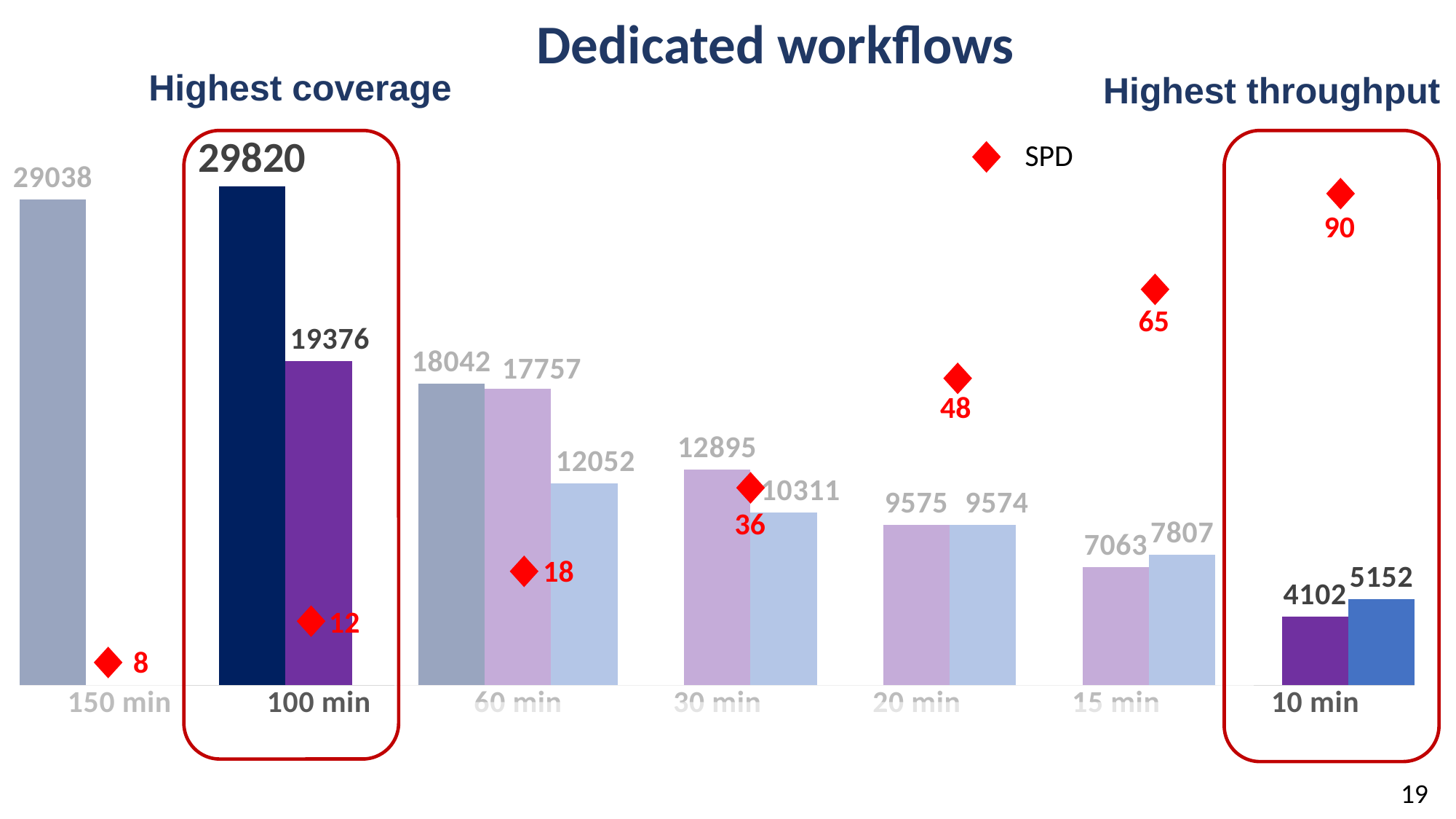
What is the value of the tallest bar at 100 min? 29820 Which category has the lowest SPD value? 150 min Which is larger, the SPD value at 20 min or at 15 min? 15 min What kind of chart is shown on the slide? bar chart How many time categories are shown on the x axis? 7 Do the SPD values rise or fall moving from 150 min to 10 min along the x axis? rise What is the SPD value at 10 min? 90 What is the SPD value at 30 min? 36 Which category has the highest SPD value? 10 min What is the difference between the two bars at 100 min (29820 and 19376)? 10444 What is the value of the bar at 150 min? 29038 What is the title of the chart? Dedicated workflows